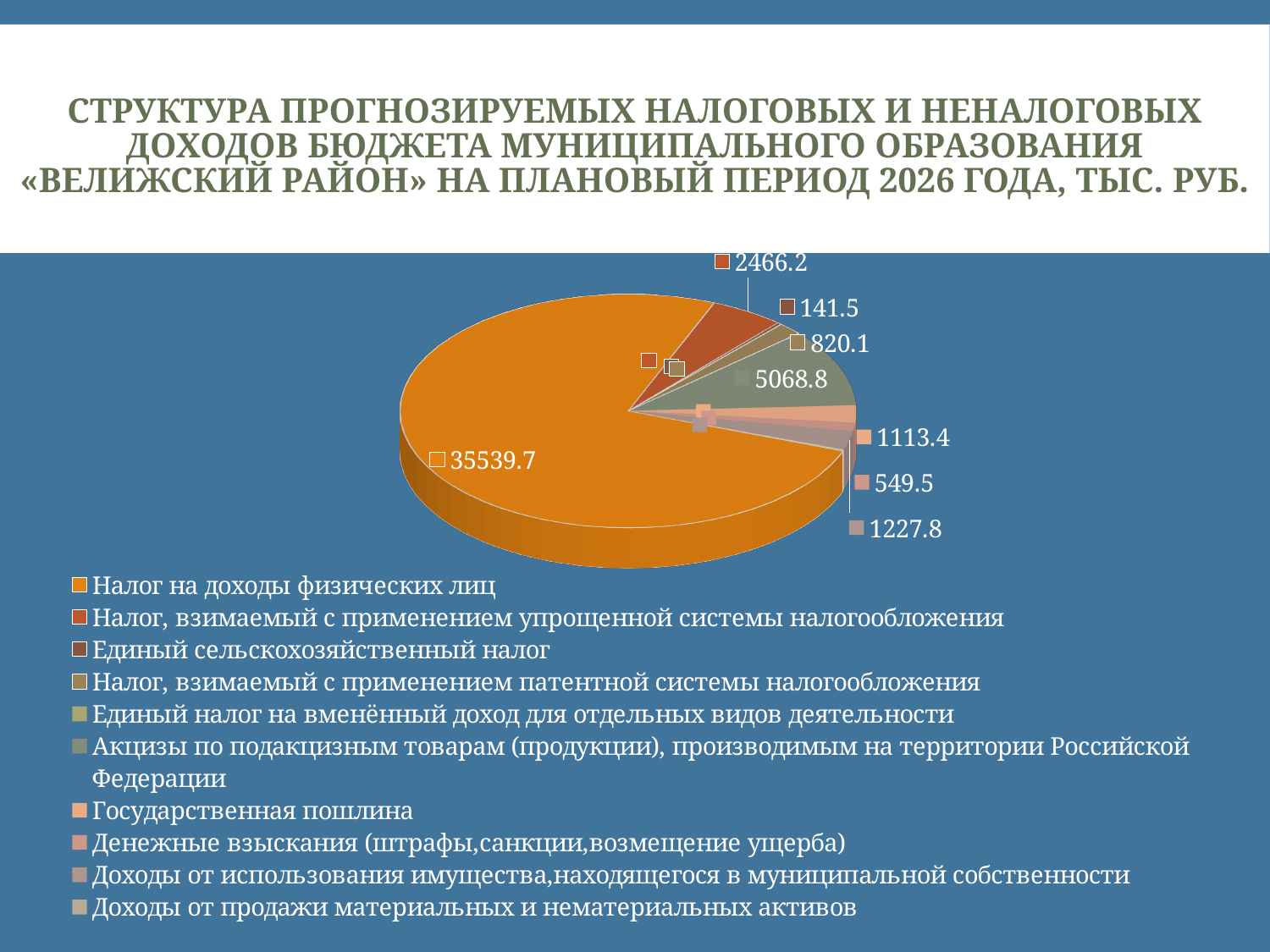
Which category has the largest slice of the pie? Налог на доходы физических лиц What is the value shown for Налог на доходы физических лиц? 35539.7 What is the value shown for Единый сельскохозяйственный налог? 141.5 What is the value shown for Акцизы по подакцизным товарам (продукции), производимым на территории Российской Федерации? 5068.8 What is the value shown for Налог, взимаемый с применением упрощенной системы налогообложения? 2466.2 What is the value shown for Налог, взимаемый с применением патентной системы налогообложения? 820.1 What is the difference between the value for Налог на доходы физических лиц and the value for Акцизы по подакцизным товарам? 30470.9 What kind of chart is shown on the slide? pie chart What is the difference between the values 1113.4 and 549.5 shown on the pie chart? 563.9 How many categories does the legend of the pie chart list? 10 In what units are the values on the chart given, according to the slide title? тыс. руб. Which is larger: the value for Налог, взимаемый с применением упрощенной системы налогообложения, or the value for Налог, взимаемый с применением патентной системы налогообложения? Налог, взимаемый с применением упрощенной системы налогообложения